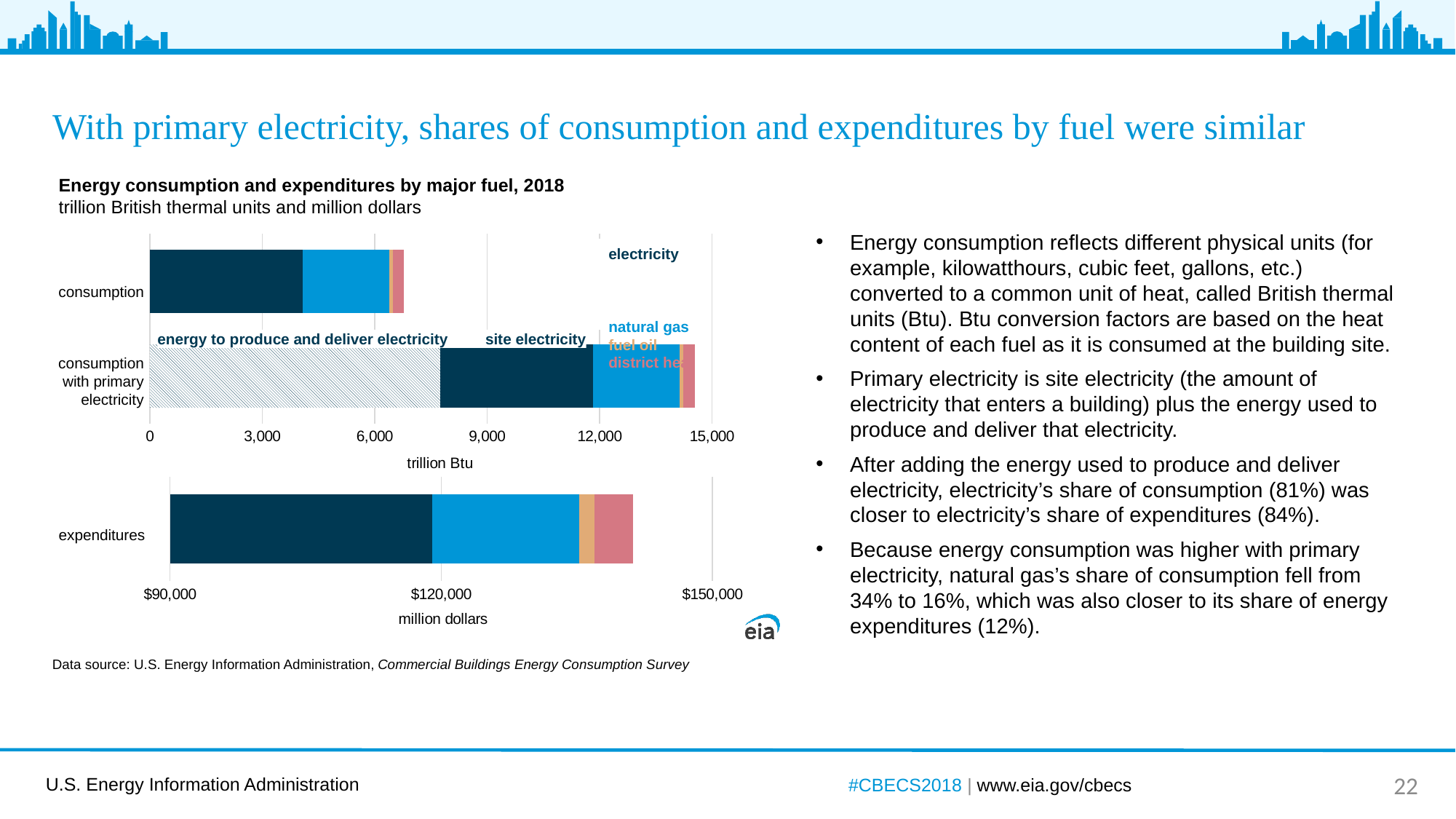
In the trillion Btu chart, is the total value for 'consumption' greater or less than 6,000? greater In the trillion Btu chart, which bar is longer: 'consumption' or 'consumption with primary electricity'? consumption with primary electricity What kind of chart is used to show energy consumption in trillion Btu? stacked bar chart In the trillion Btu chart, is the total value for 'consumption with primary electricity' greater or less than 15,000? less In the million dollars chart, is the end of the 'expenditures' bar greater or less than $120,000? greater In the 'consumption' bar of the trillion Btu chart, which segment is larger: electricity or natural gas? electricity In the trillion Btu chart, how many bars are plotted? 2 In the million dollars chart, which segment of the 'expenditures' bar is larger: electricity or natural gas? electricity What is the title of the chart on the slide? Energy consumption and expenditures by major fuel, 2018